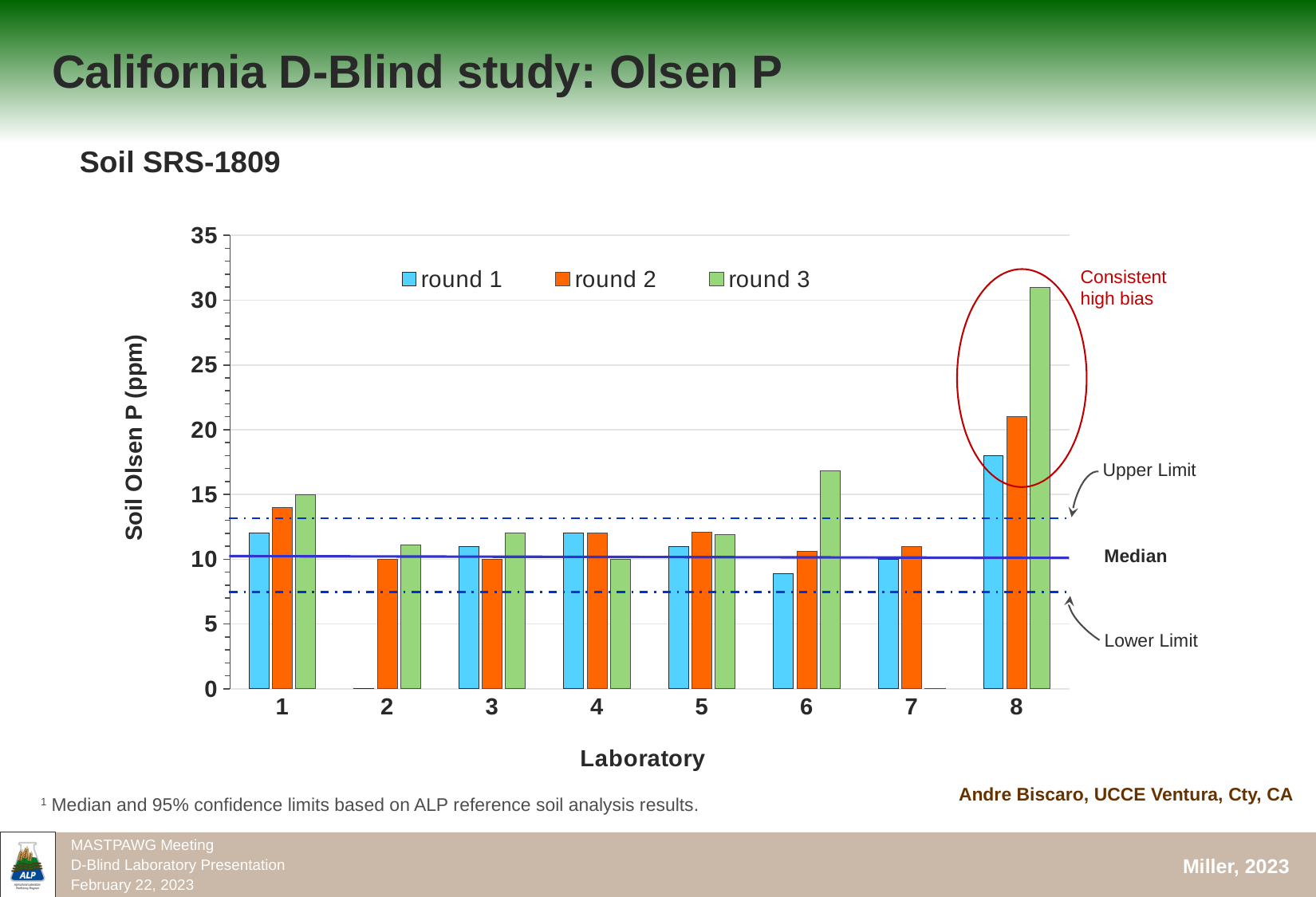
What is the label of the y axis? Soil Olsen P (ppm) What kind of chart is shown on the slide? bar chart Is the round 1 value for laboratory 8 greater or less than 15? greater Which laboratory has the highest round 3 value? 8 Is the round 2 value for laboratory 1 greater or less than 10? greater Is the round 3 value for laboratory 8 greater or less than 25? greater Which is larger, the round 1 value for laboratory 4 or the round 1 value for laboratory 6? laboratory 4 How many series does the legend list? 3 Which laboratory is circled and annotated as 'Consistent high bias'? 8 Which laboratory has the highest round 2 value? 8 How many laboratories are shown on the x axis? 8